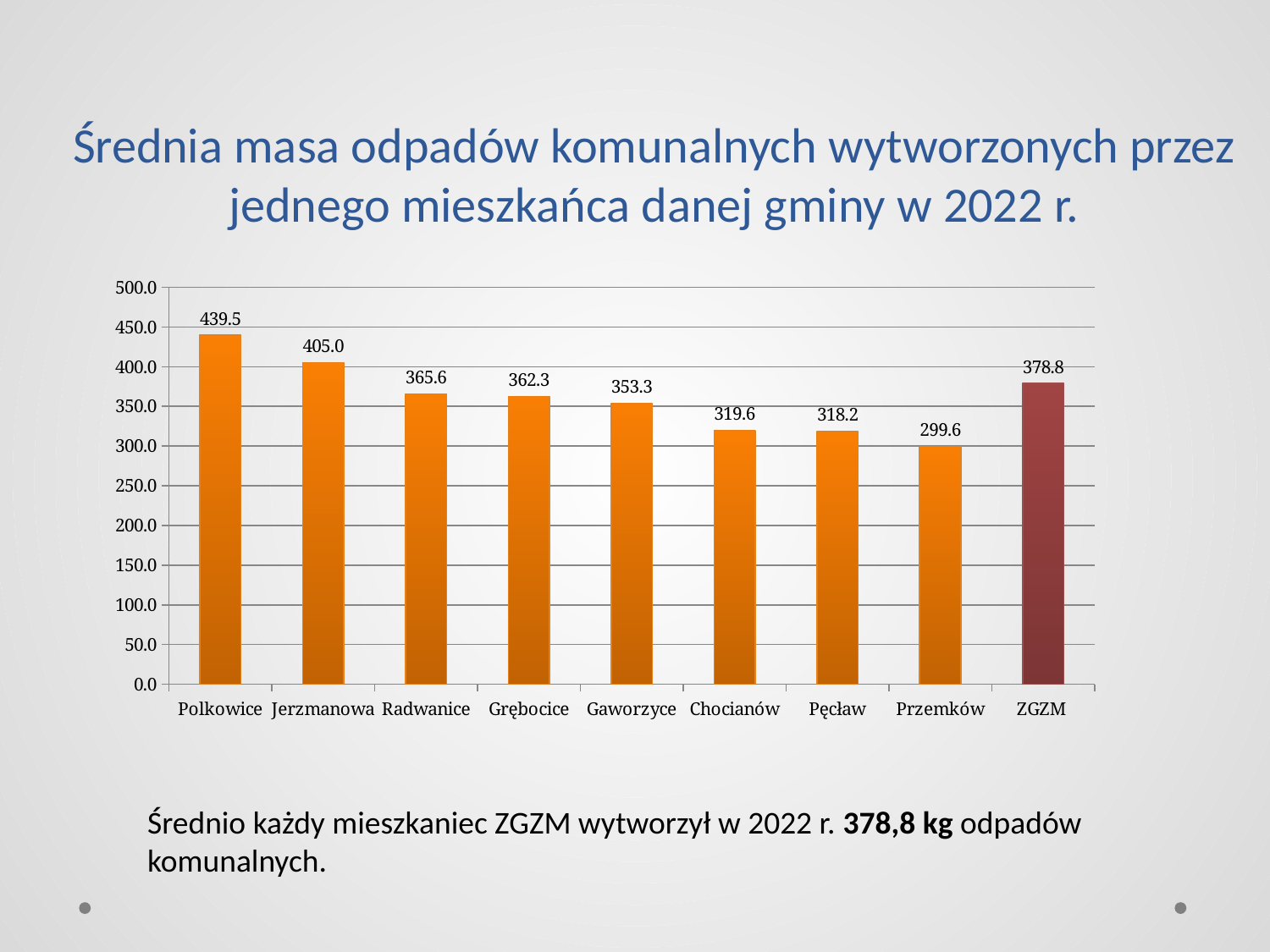
What kind of chart is shown on the slide? bar chart What is the value for Polkowice? 439.5 Which category has the highest value? Polkowice How many categories are shown on the x axis? 9 Is the value for Przemków greater or less than 300.0? less What is the difference between the values for Polkowice and Jerzmanowa? 34.5 What is the difference between the values for ZGZM and Przemków? 79.2 Which category has the lowest value? Przemków What is the value for Chocianów? 319.6 Which bar is drawn in a different colour from the others? ZGZM Which is larger, the value for Gaworzyce or the value for ZGZM? ZGZM What is the value for ZGZM? 378.8